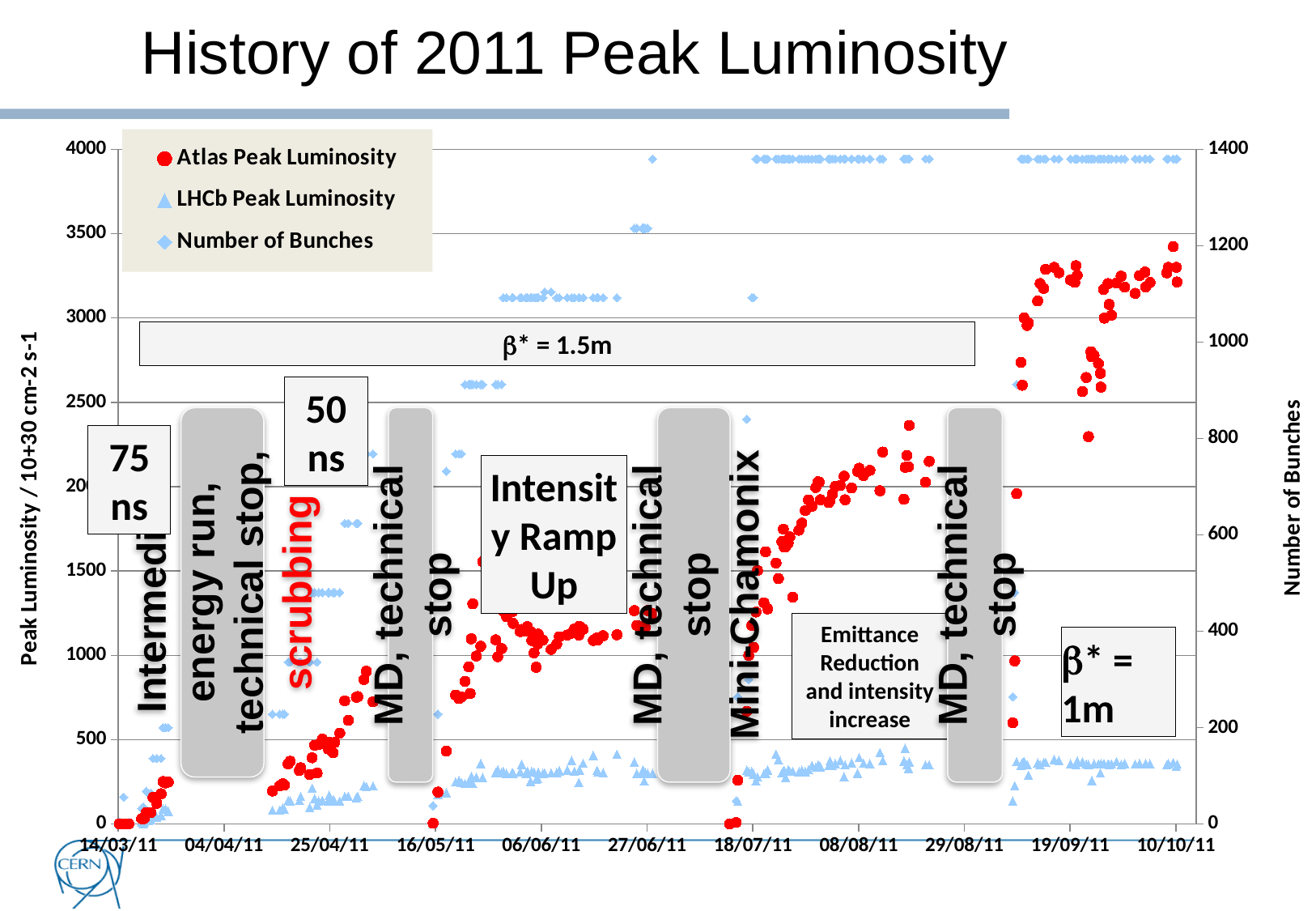
Is the Atlas Peak Luminosity at 10/10/11 greater or less than 3000? greater Does the Atlas Peak Luminosity generally rise or fall from 14/03/11 to 10/10/11? rise What is the title of the slide's chart? History of 2011 Peak Luminosity Is the Atlas Peak Luminosity around 06/06/11 greater or less than 1500? less What kind of chart is shown on the slide? scatter chart What β* value is annotated for the period after the last technical stop, at the right of the chart? β* = 1m Is the Atlas Peak Luminosity around 08/08/11 greater or less than 1500? greater How many series does the legend list? 3 How many date labels are shown on the x axis? 11 Which is larger at 19/09/11, the Atlas Peak Luminosity or the LHCb Peak Luminosity? Atlas Peak Luminosity